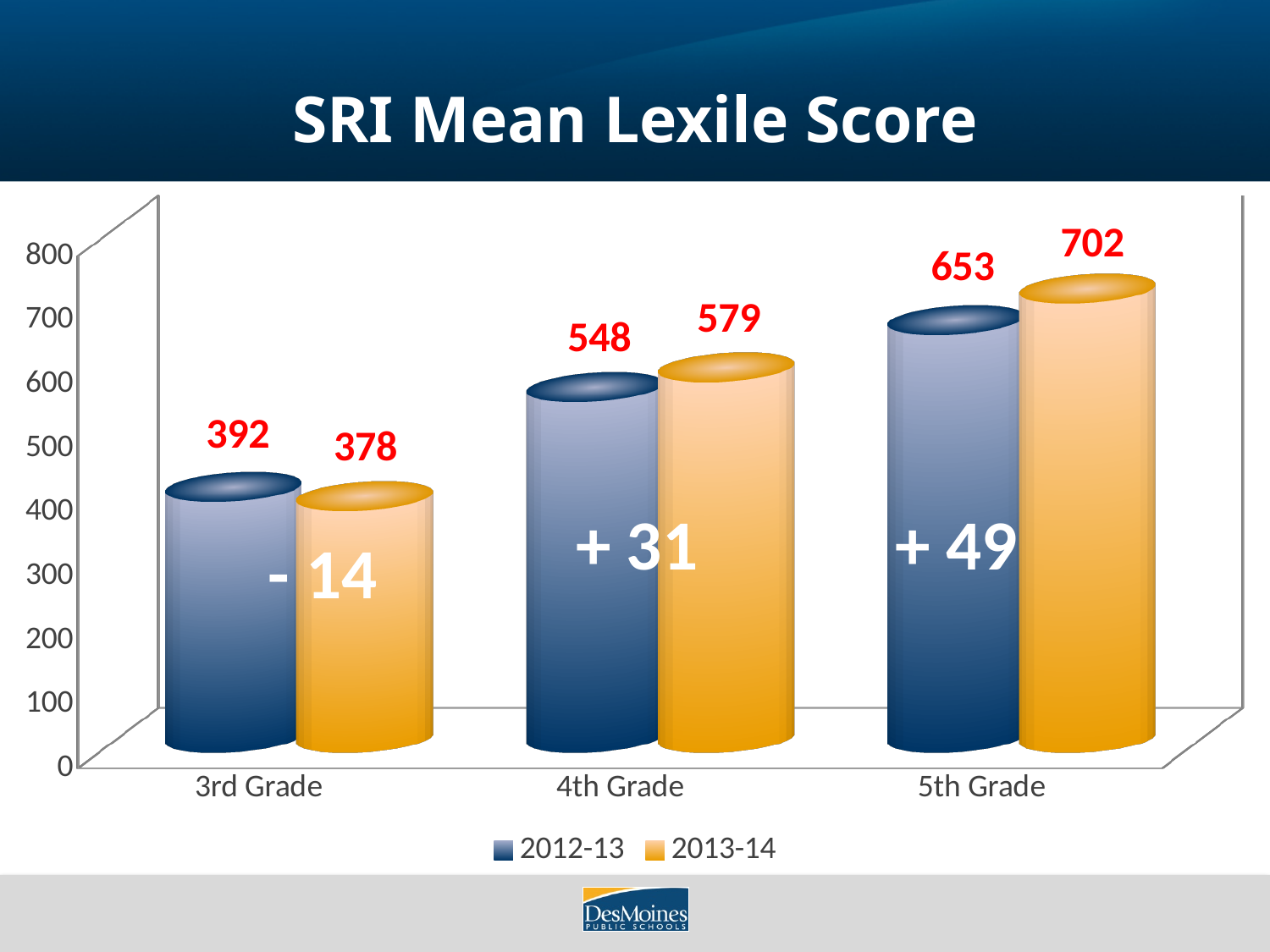
How many series does the legend list? 2 What type of chart is shown on the slide? Bar chart What is the difference between the 2013-14 and 2012-13 scores for 5th Grade? 49 Is the 2012-13 score for 5th Grade greater or less than 600? greater What is the 2013-14 SRI mean Lexile score for 5th Grade? 702 Which is larger for 4th Grade, the 2012-13 score or the 2013-14 score? 2013-14 What is the difference between the 2012-13 and 2013-14 scores for 3rd Grade? 14 Which grade has the highest 2013-14 mean Lexile score? 5th Grade How many grade categories are shown on the chart? 3 What is the 2012-13 SRI mean Lexile score for 3rd Grade? 392 What is the 2013-14 SRI mean Lexile score for 4th Grade? 579 Which grade has the lowest 2012-13 mean Lexile score? 3rd Grade